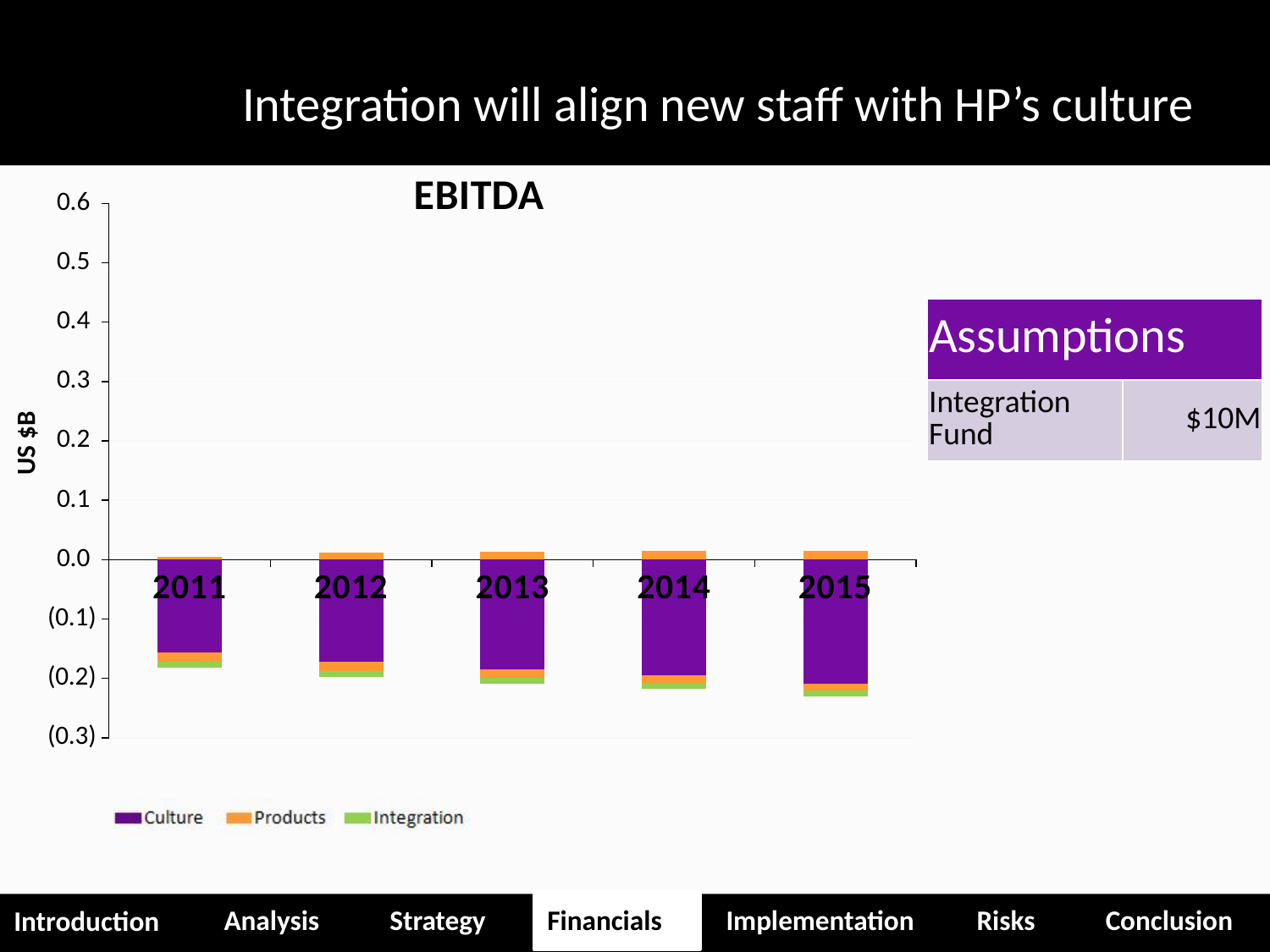
Does the negative stacked total become larger or smaller in magnitude from 2011 to 2015? larger How many years are shown on the x axis of the EBITDA chart? 5 How many series does the chart legend list? 3 What kind of chart is shown on the slide? stacked bar chart What is the title of the chart? EBITDA Is the bottom of the stacked bar for 2015 greater or less than (0.2)? less Is the Culture value for 2015 greater or less than 0.0? less Which year has the largest negative stacked total in the EBITDA chart? 2015 Which year has the smallest negative stacked total in the EBITDA chart? 2011 Is the Culture value for 2011 greater or less than (0.1)? less Which year's stacked bar extends further below zero, 2011 or 2015? 2015 What label is shown on the vertical axis of the chart? US $B